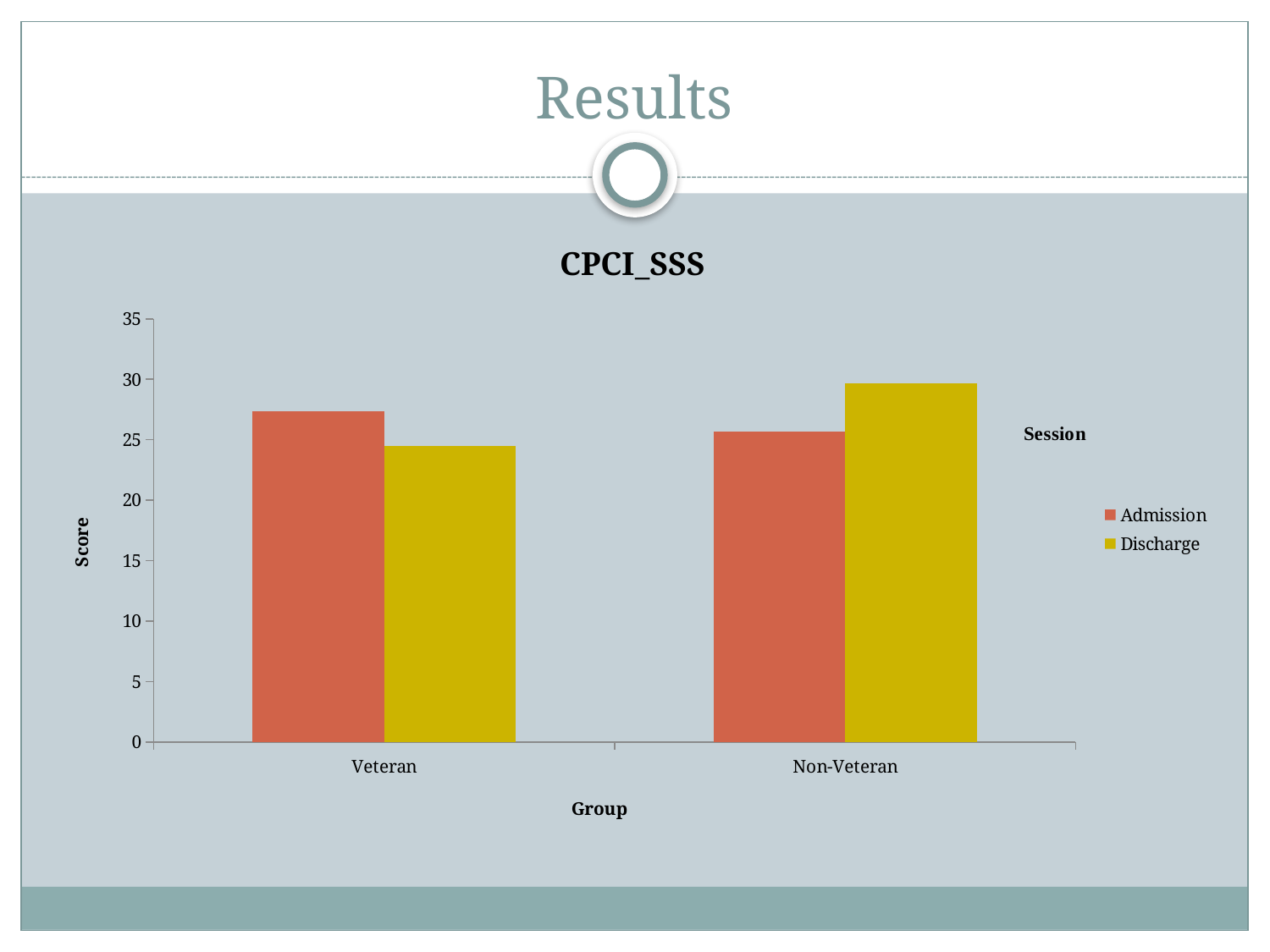
Is the Admission score for the Non-Veteran group greater or less than 30? less What is the label of the y axis? Score Which bar is the highest in the chart? Non-Veteran Discharge For the Non-Veteran group, which is larger: the Admission score or the Discharge score? Discharge How many groups are shown on the x axis? 2 How many series does the legend list? 2 Is the Discharge score for the Veteran group greater or less than 20? greater What kind of chart is shown on the slide? bar chart Is the Discharge score for the Non-Veteran group greater or less than 25? greater For the Veteran group, which is larger: the Admission score or the Discharge score? Admission What is the title of the chart? CPCI_SSS